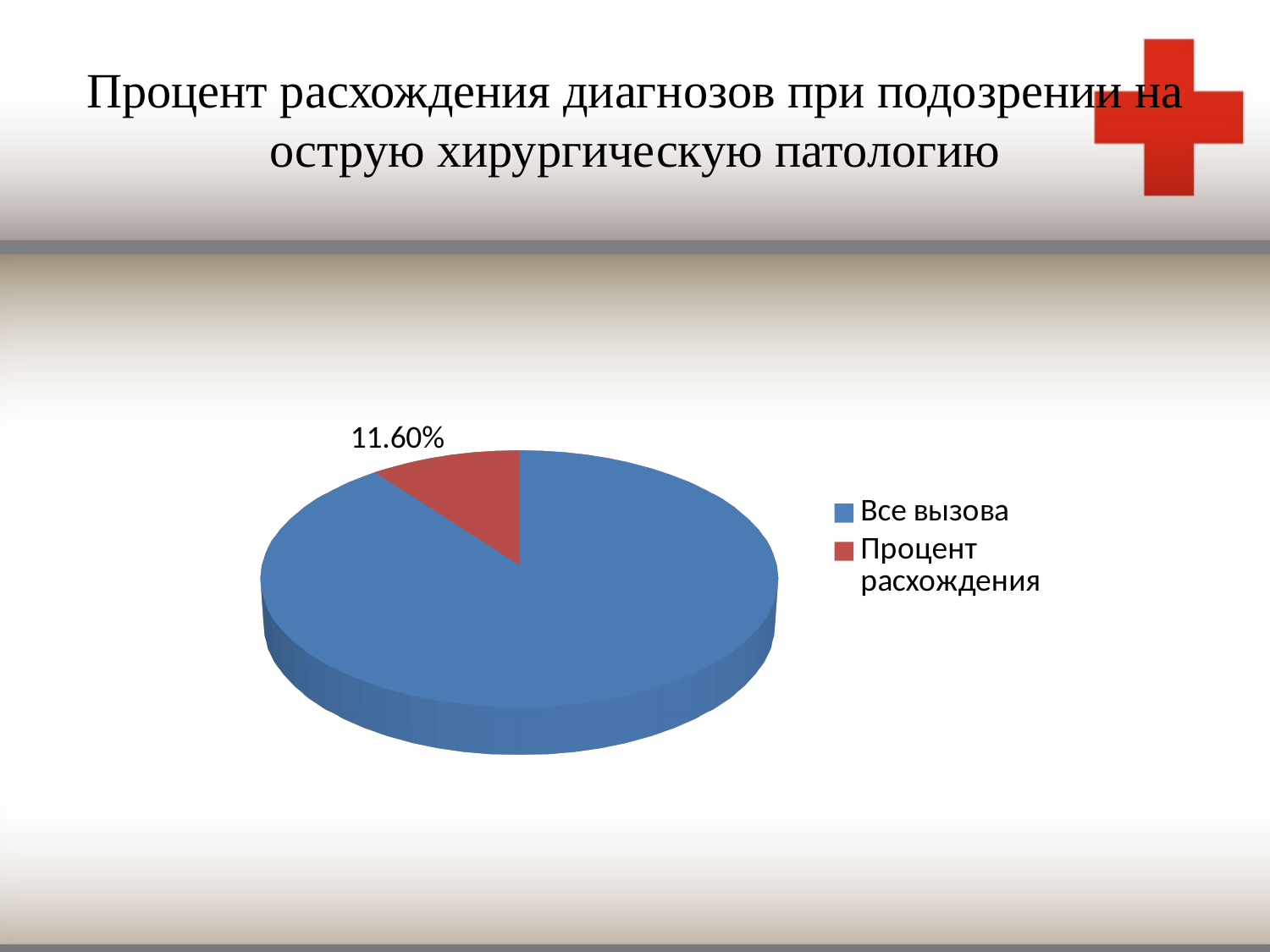
What kind of chart is shown on the slide? pie chart What colour is the slice for Все вызова? blue Which slice is larger, Все вызова or Процент расхождения? Все вызова What value is labelled on the slice for Процент расхождения? 11.60% How many slices does the pie chart have? 2 Which slice of the pie is the smallest? Процент расхождения Which slice of the pie is the largest? Все вызова How many entries does the legend list? 2 What colour is the slice for Процент расхождения? red